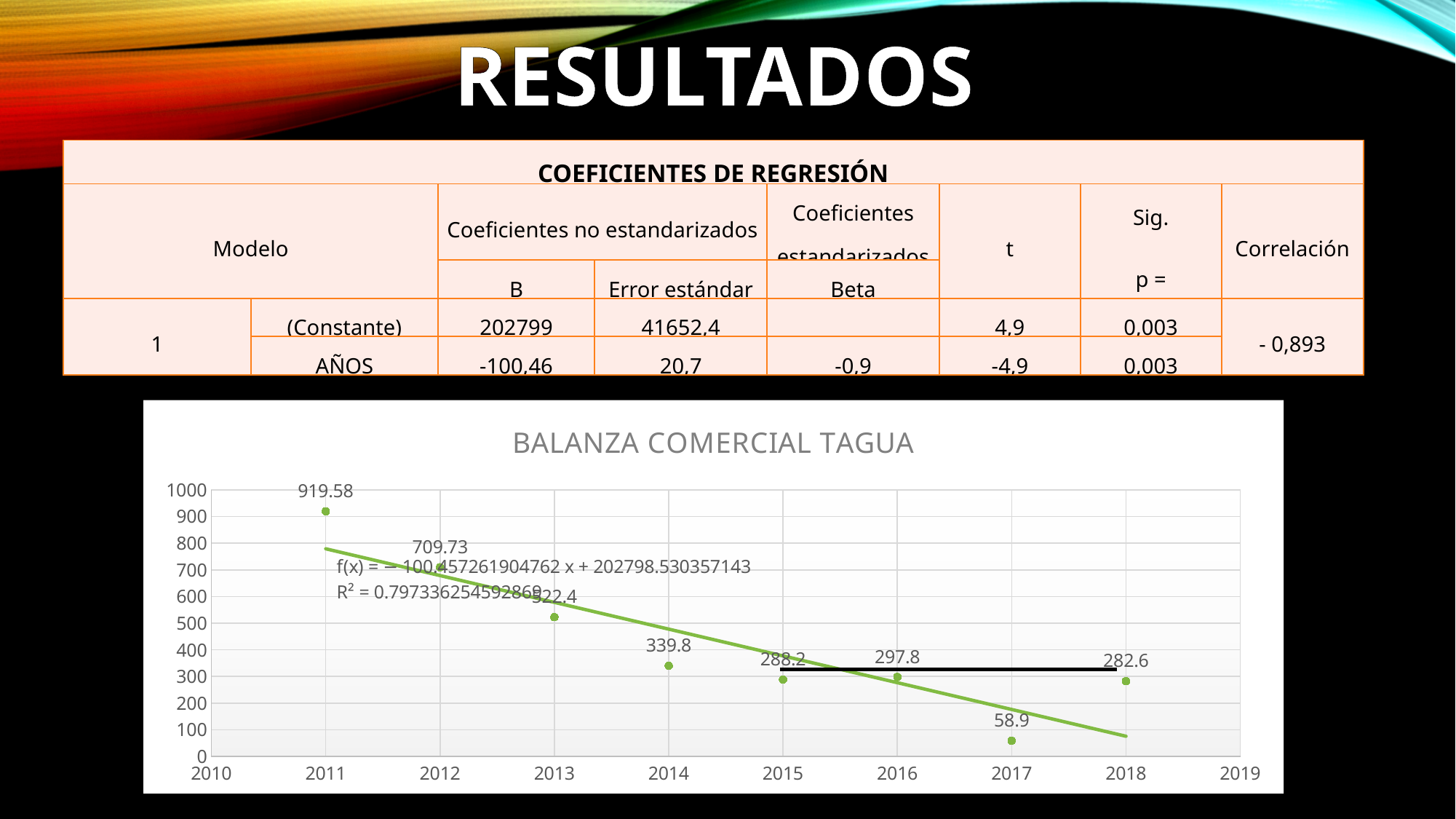
Do the values generally rise or fall from 2011 to 2018? fall What is the value plotted for 2017? 58.9 Which year has the highest value? 2011 What is the title of the chart? BALANZA COMERCIAL TAGUA What type of chart is shown on the slide? scatter chart What is the value plotted for 2018? 282.6 Which is larger, the value for 2015 or the value for 2016? 2016 What is the value plotted for 2014? 339.8 What is the difference between the values for 2013 and 2014? 182.6 Is the value for 2012 greater or less than 600? greater Which year has the lowest value? 2017 What is the value plotted for 2011? 919.58